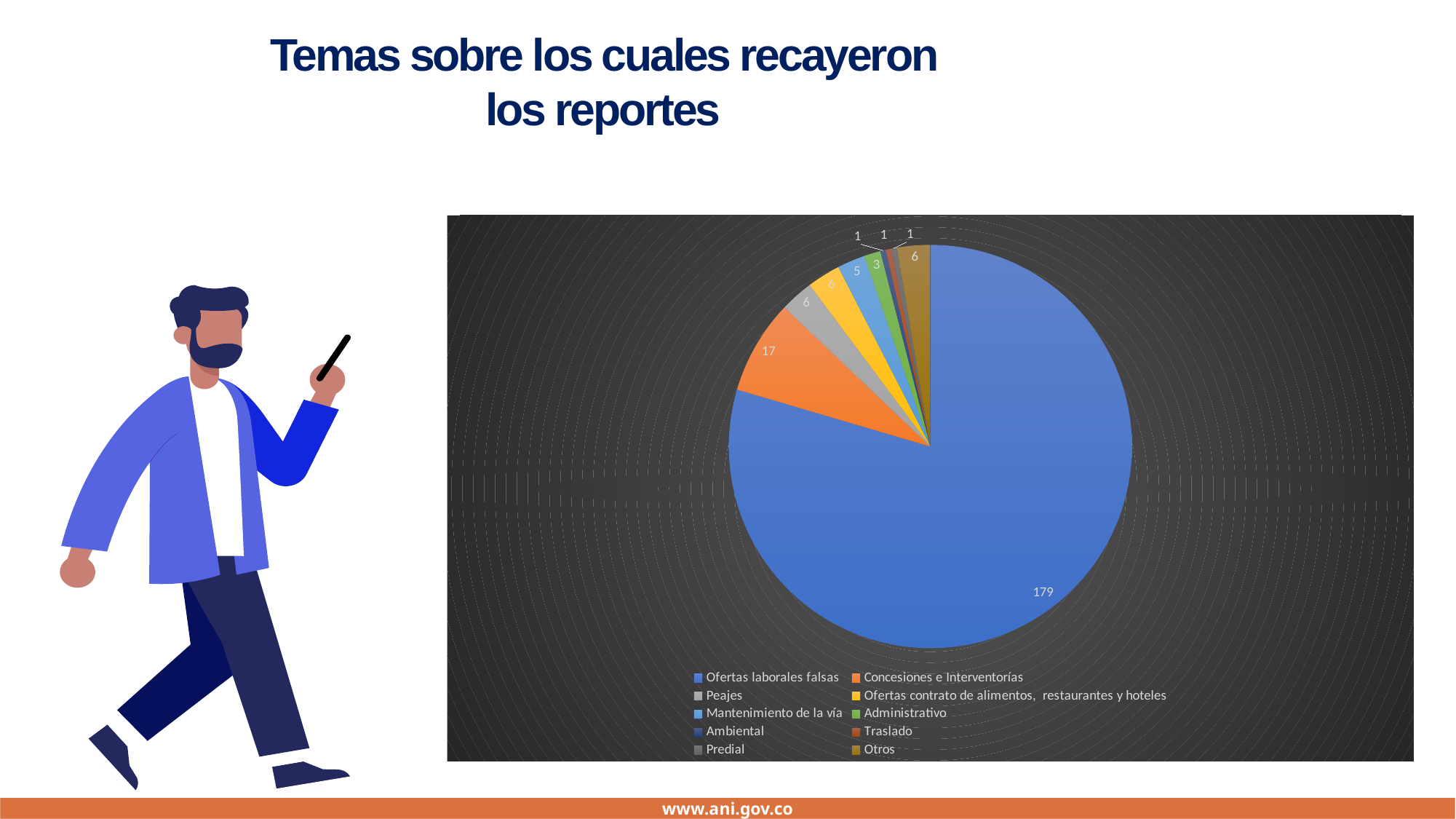
What is the value for Concesiones e Interventorías? 17 How many categories does the legend list? 10 Which is larger, the value for Peajes or the value for Mantenimiento de la vía? Peajes What is the total of all the slice values in the pie chart? 225 What is the title of the slide containing the pie chart? Temas sobre los cuales recayeron los reportes What type of chart is shown on the slide? Pie chart Which categories share the smallest value in the pie chart? Ambiental, Traslado, Predial What is the value for Ofertas laborales falsas? 179 What is the value for Mantenimiento de la vía? 5 What is the difference between the values for Ofertas laborales falsas and Concesiones e Interventorías? 162 Which category has the largest slice of the pie? Ofertas laborales falsas What is the value for Administrativo? 3